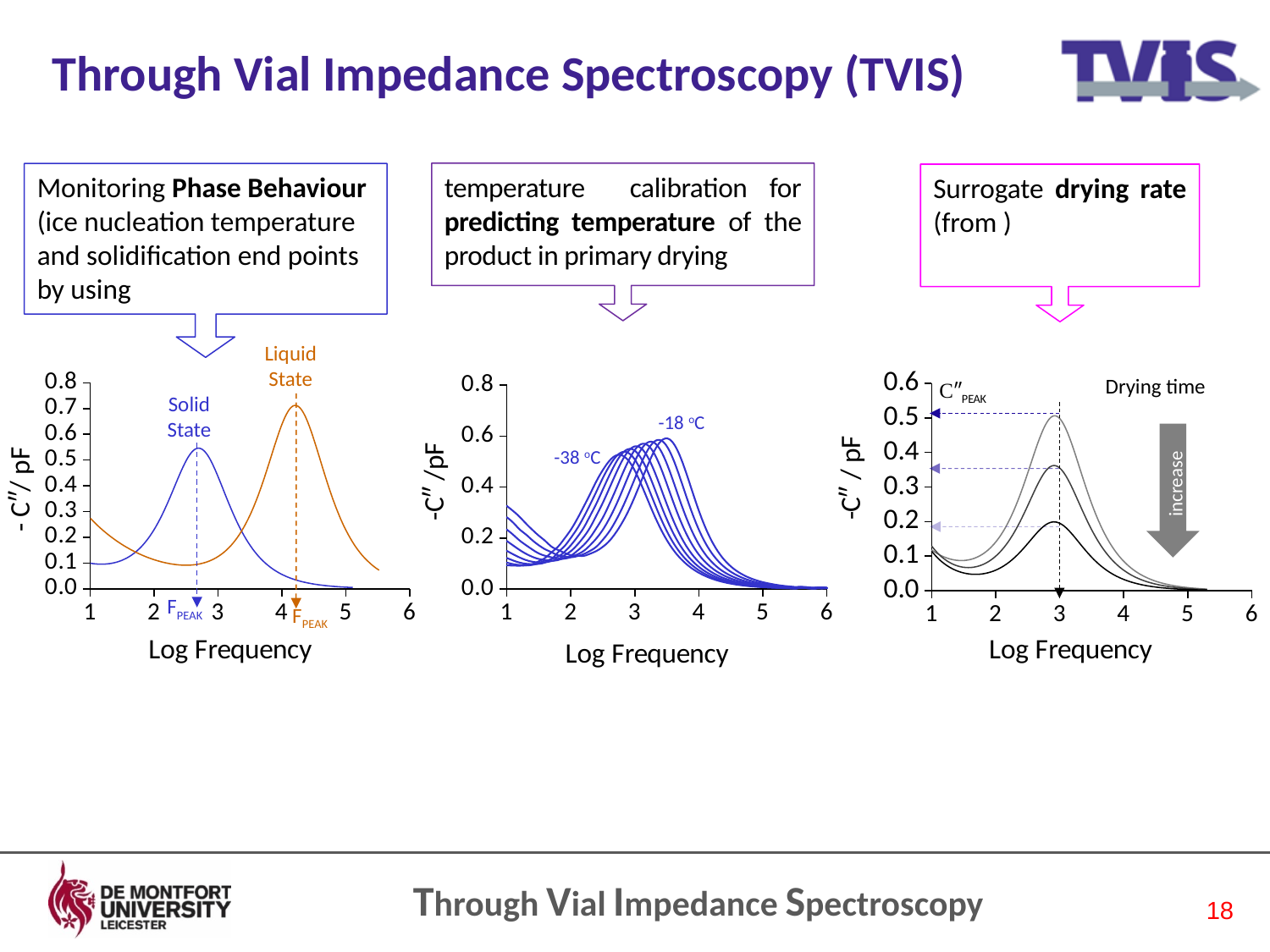
What is the x-axis label of the left chart? Log Frequency In the left chart, which curve reaches the higher peak, Solid State or Liquid State? Liquid State In the right chart, does the peak value of the curves rise or fall as drying time increases? fall What kind of chart is the left chart (Solid State / Liquid State)? line chart In the left chart, which curve peaks at a higher Log Frequency, Solid State or Liquid State? Liquid State In the middle chart, which curve peaks at a higher Log Frequency, the -38 °C curve or the -18 °C curve? -18 °C In the middle chart, is the peak value of the -18 °C curve greater or less than 0.4? greater How many curves are plotted in the right chart (Drying time)? 3 In the left chart, is the peak value of the Liquid State curve greater or less than 0.6? greater In the right chart, at what Log Frequency does the dashed vertical line through the peaks sit? 3 In the left chart, is the peak value of the Solid State curve greater or less than 0.4? greater In the middle chart, which temperature labels are shown on the curves? -38 °C and -18 °C